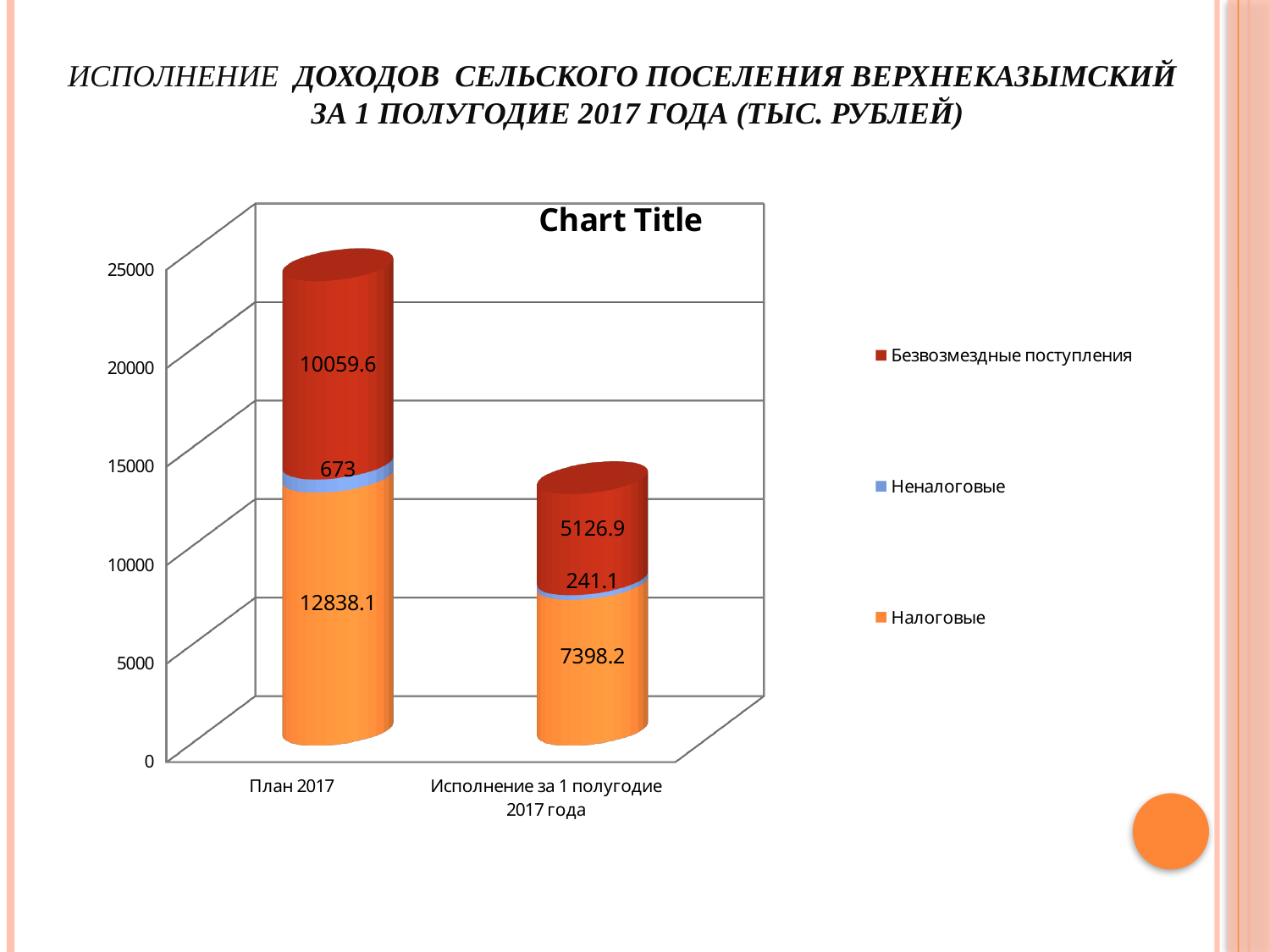
How many categories are shown on the x axis? 2 What is the difference between the Безвозмездные поступления values for План 2017 and Исполнение за 1 полугодие 2017 года? 4932.7 What is the value of Налоговые for План 2017? 12838.1 What is the value of Неналоговые for Исполнение за 1 полугодие 2017 года? 241.1 What kind of chart is shown on the slide? Stacked bar chart What is the total of the stacked bar for Исполнение за 1 полугодие 2017 года? 12766.2 What is the difference between the Налоговые values for План 2017 and Исполнение за 1 полугодие 2017 года? 5439.9 How many series does the legend list? 3 What is the value of Безвозмездные поступления for Исполнение за 1 полугодие 2017 года? 5126.9 Which category has the higher Налоговые value, План 2017 or Исполнение за 1 полугодие 2017 года? План 2017 What is the total of the stacked bar for План 2017? 23570.7 What is the value of Неналоговые for План 2017? 673